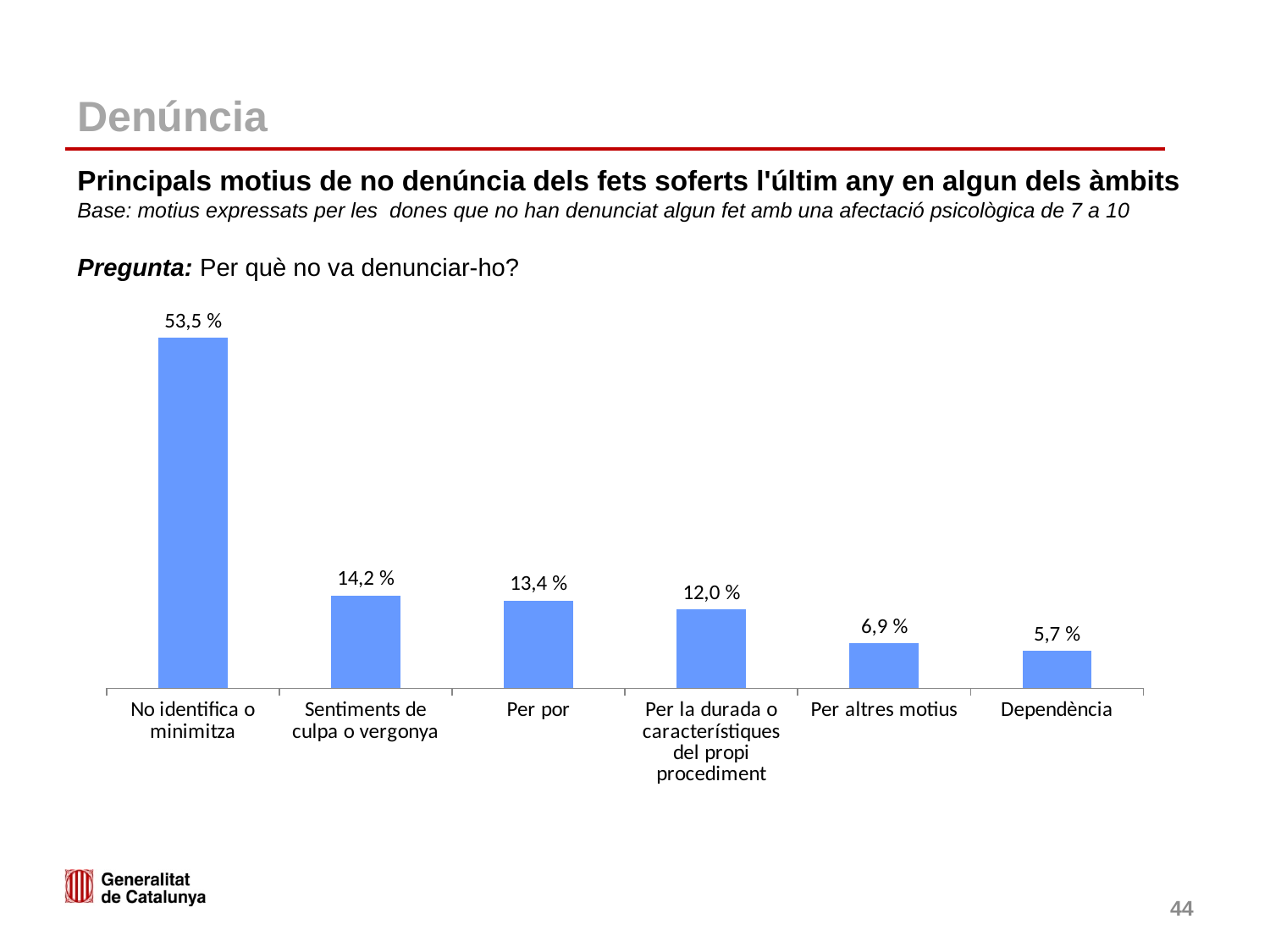
How many categories are shown in the chart? 6 What is the value for "No identifica o minimitza"? 53,5 % What is the difference between the values for "Per altres motius" and "Dependència"? 1,2 % What is the value for "Per por"? 13,4 % Which is larger, the value for "Sentiments de culpa o vergonya" or the value for "Per por"? Sentiments de culpa o vergonya What is the value for "Per la durada o característiques del propi procediment"? 12,0 % What is the value for "Dependència"? 5,7 % What kind of chart is shown on the slide? Bar chart What is the difference between the values for "No identifica o minimitza" and "Sentiments de culpa o vergonya"? 39,3 % Which category has the highest value? No identifica o minimitza Which category has the lowest value? Dependència Do the values rise or fall from left to right along the x axis? Fall